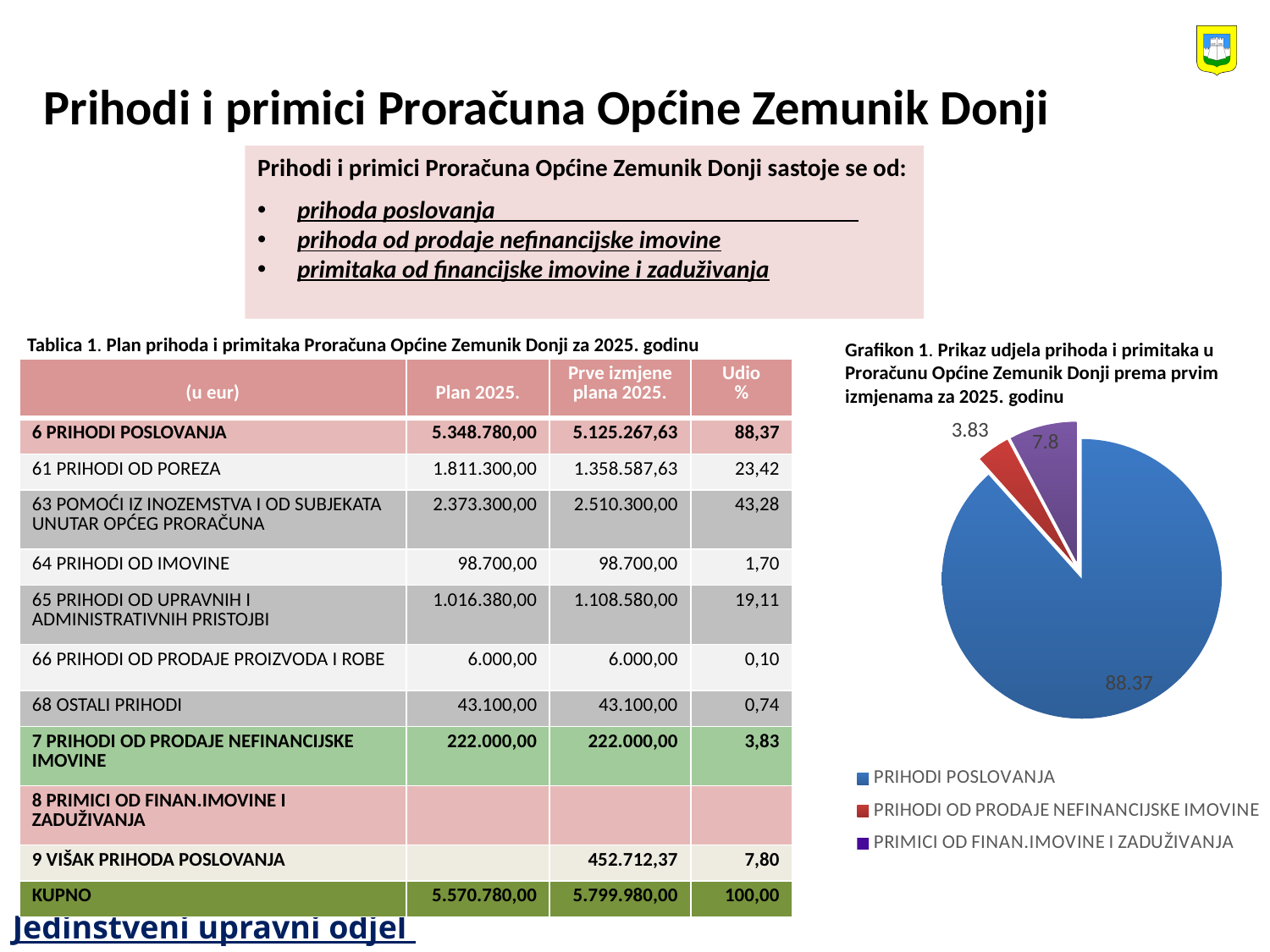
Which category has the smallest slice in the pie chart? PRIHODI OD PRODAJE NEFINANCIJSKE IMOVINE What colour is the PRIHODI POSLOVANJA slice in the pie chart? blue How many slices does the pie chart have? 3 How many entries does the legend of the pie chart list? 3 What is the title of the pie chart on the slide? Grafikon 1. Prikaz udjela prihoda i primitaka u Proračunu Općine Zemunik Donji prema prvim izmjenama za 2025. godinu Which category has the largest slice in the pie chart? PRIHODI POSLOVANJA What kind of chart is Grafikon 1 on the slide? pie chart In the pie chart, what is the value shown for PRIHODI POSLOVANJA? 88.37 In the pie chart, what is the value shown for PRIHODI OD PRODAJE NEFINANCIJSKE IMOVINE? 3.83